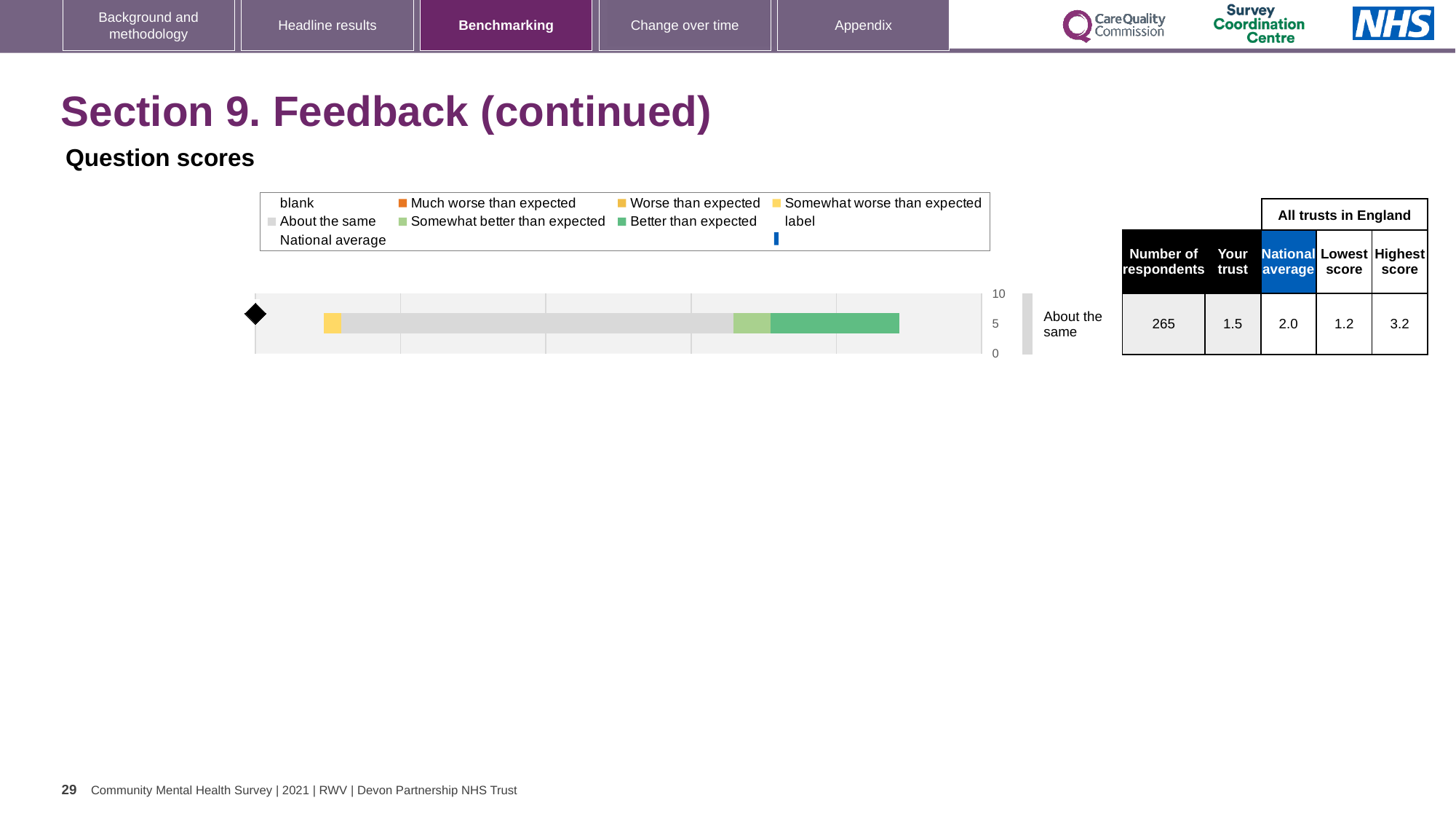
What kind of chart is shown on the slide? bar chart What colour does the legend use for 'Much worse than expected'? orange How many respondents are shown for the 'About the same' row? 265 What is the difference between the Highest score and the Lowest score shown for the 'About the same' row? 2.0 By how much does the National average exceed the 'Your trust' score for the 'About the same' row? 0.5 Which is larger for the 'About the same' row: the 'Your trust' score or the National average? National average What is the National average score shown for the 'About the same' row? 2.0 What is the 'Your trust' score shown for the 'About the same' row? 1.5 What is the Highest score among all trusts in England shown for the 'About the same' row? 3.2 What is the Lowest score among all trusts in England shown for the 'About the same' row? 1.2 What is the category label shown next to the bar in the chart? About the same How many bars (question categories) are plotted in the chart? 1